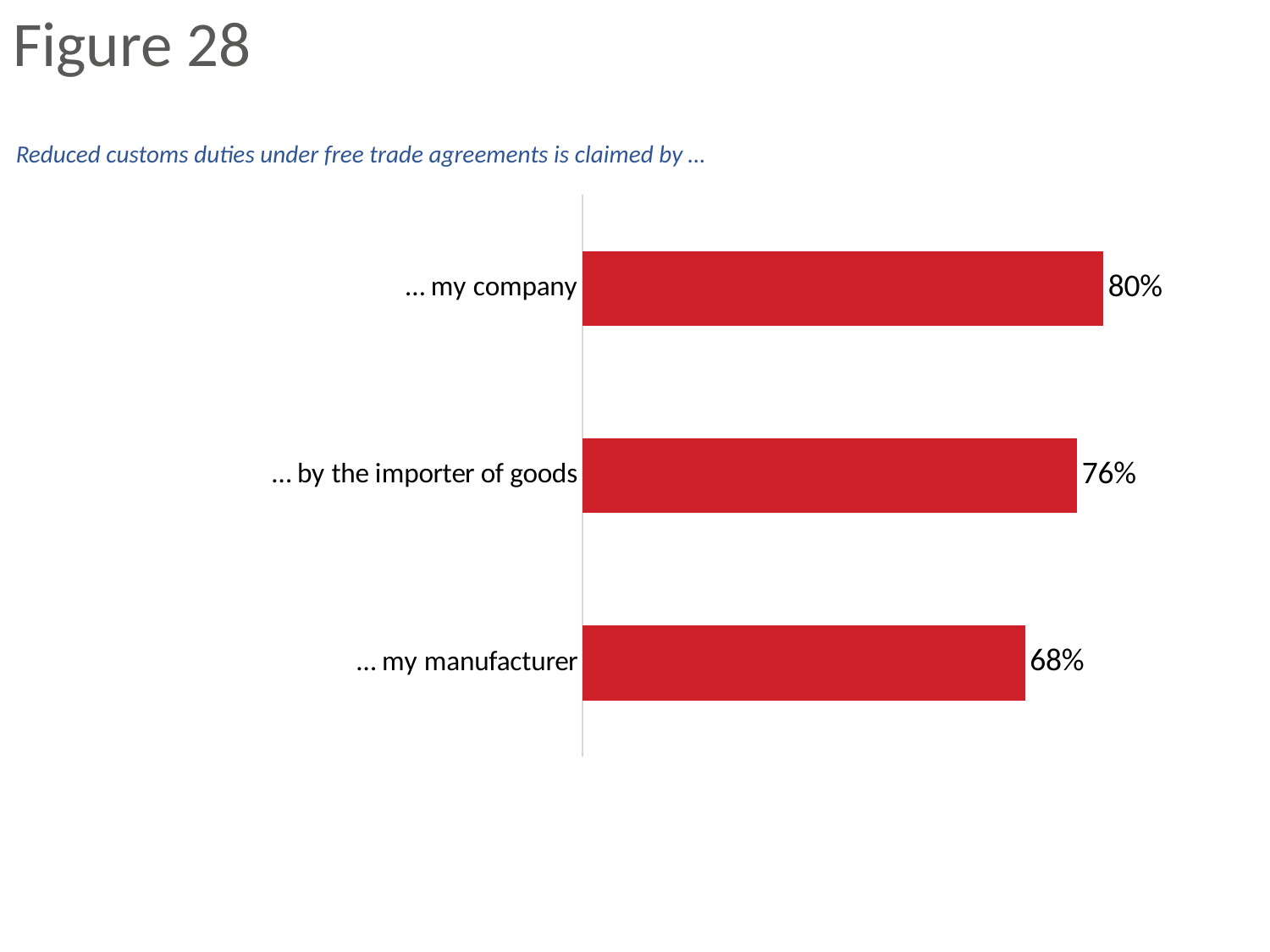
How many categories are shown in the chart? 3 What is the difference between the values for "... by the importer of goods" and "... my manufacturer"? 8% What is the value for "... by the importer of goods"? 76% Which category has the highest value? ... my company What colour are the bars in the chart? Red What kind of chart is shown on the slide? Bar chart Which is larger, the value for "... my company" or the value for "... by the importer of goods"? ... my company What is the value for "... my company"? 80% What is the subtitle text above the chart? Reduced customs duties under free trade agreements is claimed by ... What is the value for "... my manufacturer"? 68% What is the difference between the values for "... my company" and "... my manufacturer"? 12% Which category has the lowest value? ... my manufacturer